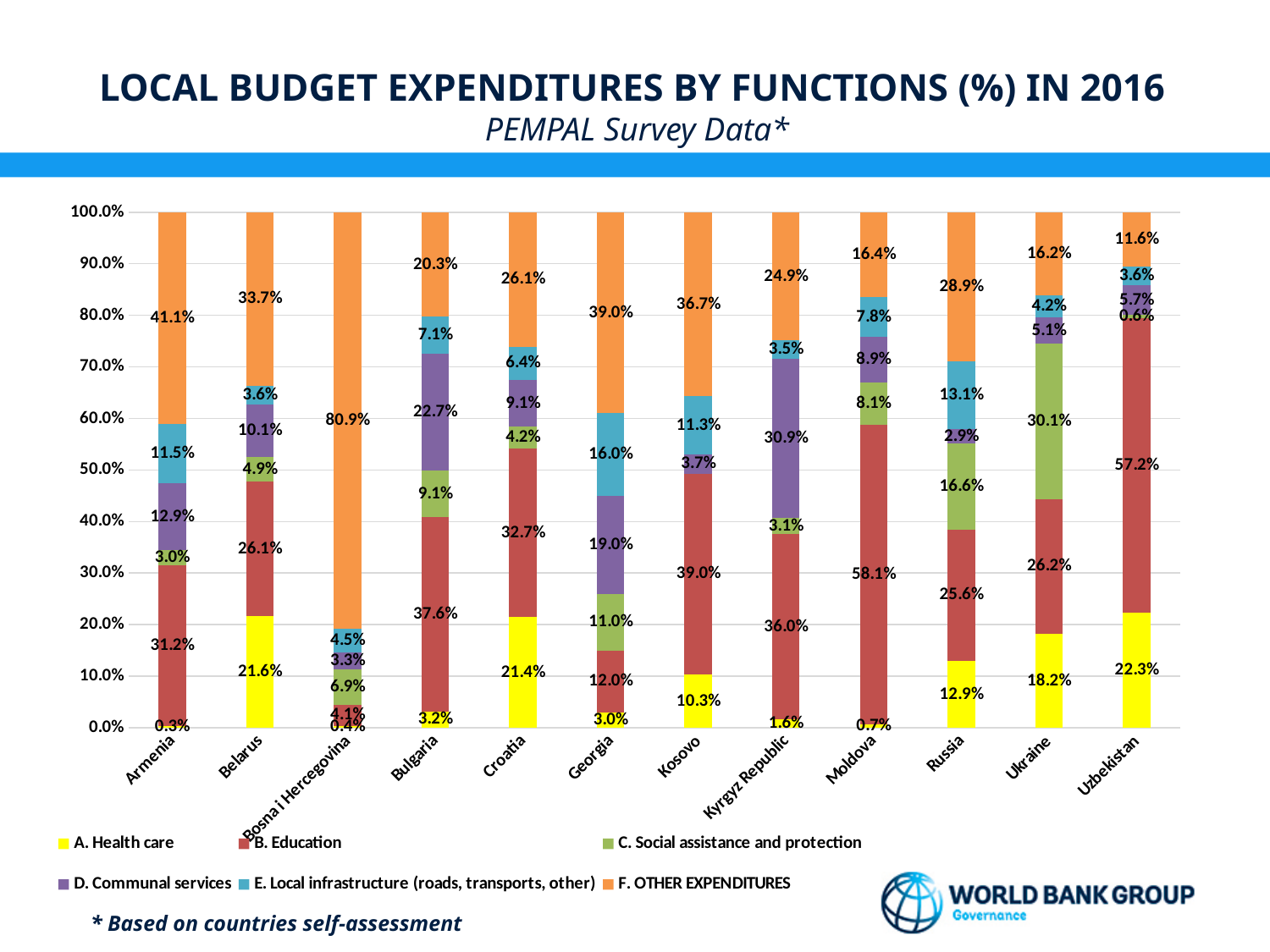
What type of chart is shown on the slide? Stacked bar chart Which country has the highest share of F. OTHER EXPENDITURES? Bosnia i Hercegovina What is the difference in percentage points between the B. Education share of Bulgaria and that of Armenia? 6.4 Which country has the highest share for B. Education? Moldova What share of local budget expenditures in Armenia goes to B. Education? 31.2% How many countries are shown on the x axis? 12 What is the value of F. OTHER EXPENDITURES for Bosnia i Hercegovina? 80.9% Which country has the lowest A. Health care share? Armenia What percentage of Ukraine's local budget expenditures is C. Social assistance and protection? 30.1% Which has a larger D. Communal services share, Georgia or Kyrgyz Republic? Kyrgyz Republic What is the A. Health care share for Russia? 12.9% How many expenditure categories does the legend list? 6